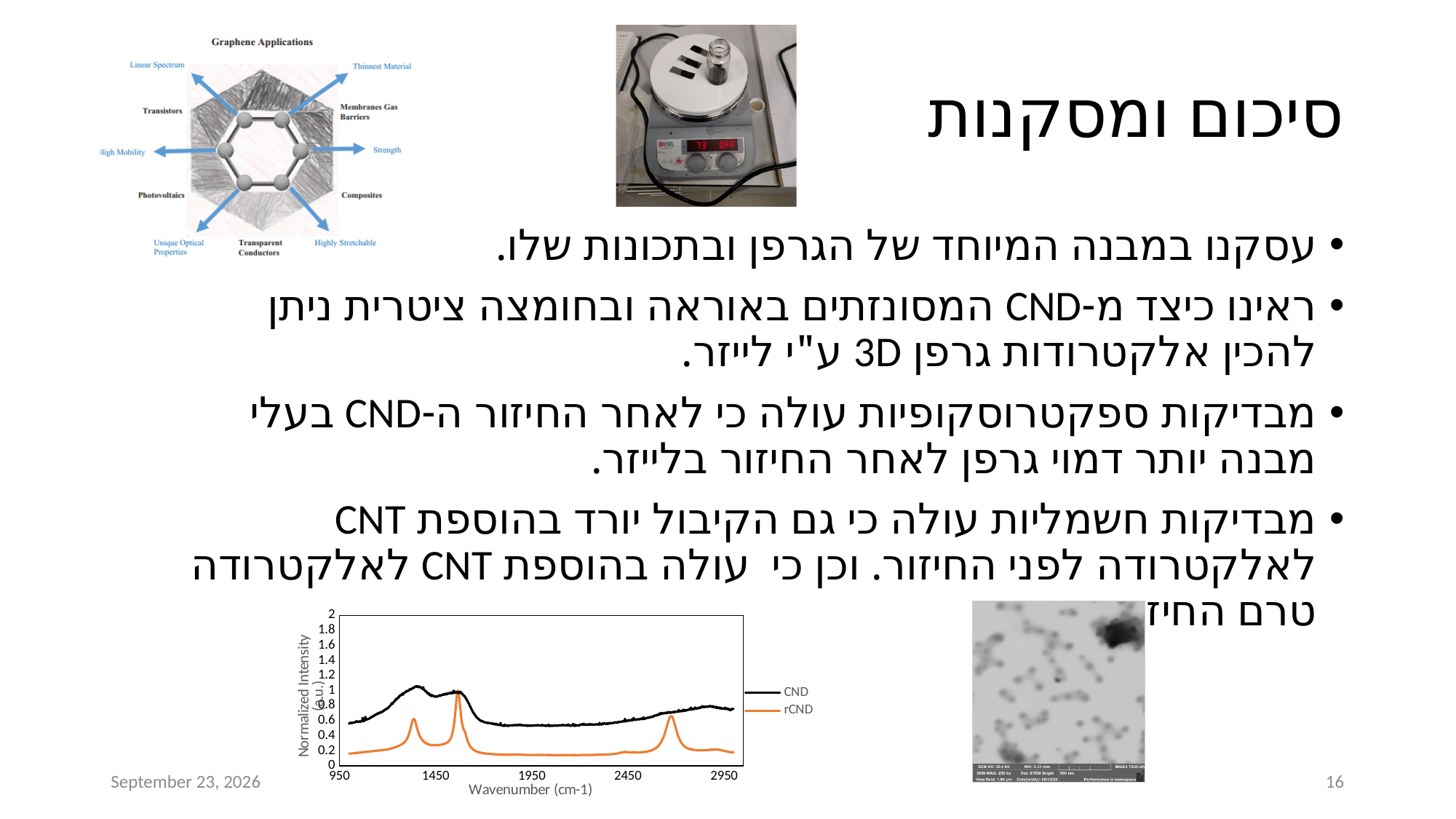
In the spectrum chart, which series is drawn in orange? rCND In the spectrum chart, is the rCND value at a wavenumber of 1950 greater or less than 0.4? less What is the x-axis title of the spectrum chart? Wavenumber (cm-1) What are the two series named in the legend of the spectrum chart? CND and rCND In the spectrum chart, is the highest rCND peak greater or less than 0.8? greater In the spectrum chart, is the highest CND value greater or less than 1.6? less In the spectrum chart, at a wavenumber of 1950, which series has the higher normalized intensity, CND or rCND? CND What kind of chart is shown at the bottom of the slide? line chart How many series does the legend of the spectrum chart list? 2